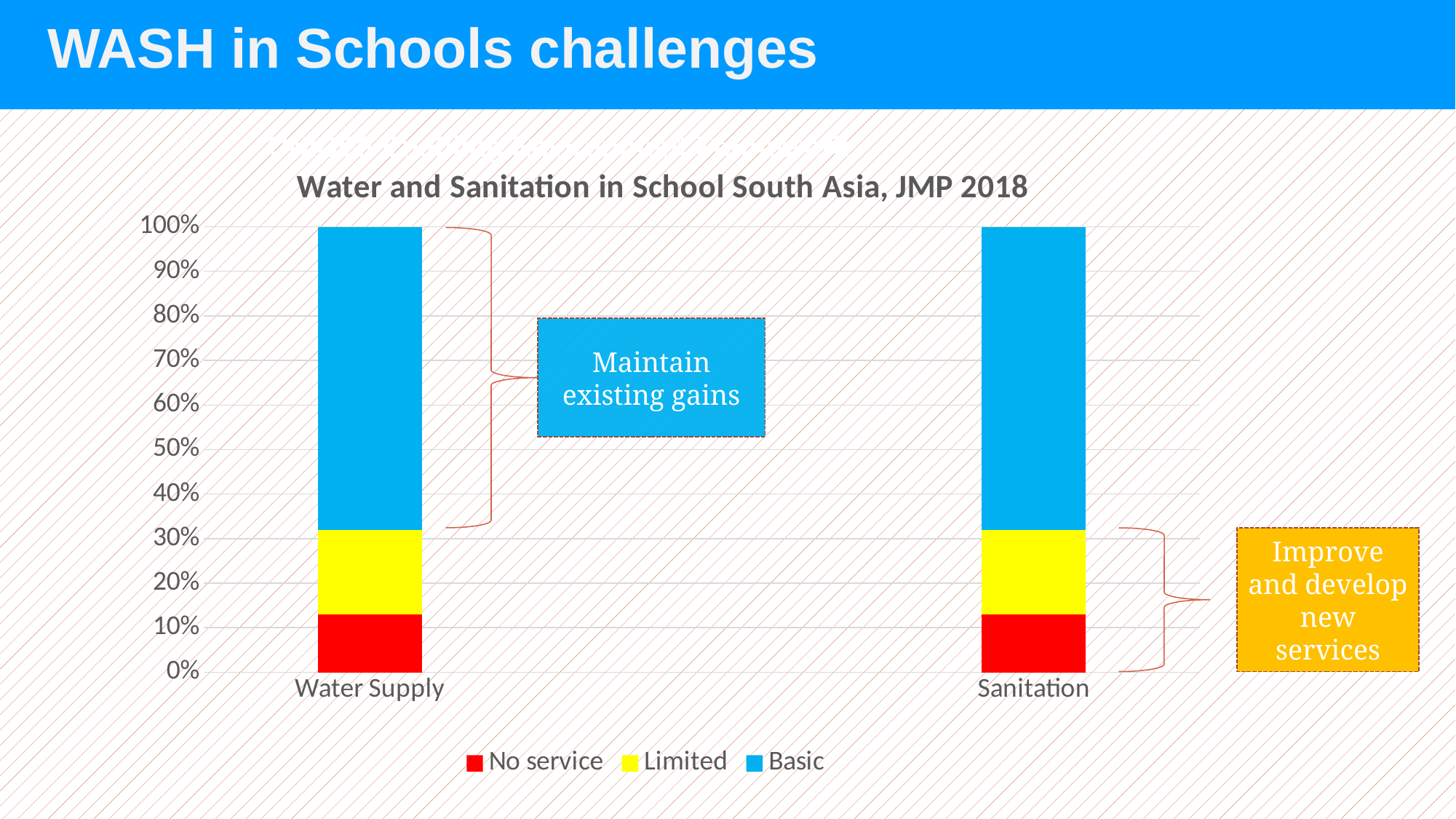
Which series makes up the smallest share of the Water Supply bar? No service Which colour represents the Basic series in the chart? Blue What is the total of the stacked bar for Water Supply? 100% Is the value for No service in Sanitation greater or less than 20%? less In the Sanitation bar, which is larger: the Basic segment or the Limited segment? Basic What is the title of the chart? Water and Sanitation in School South Asia, JMP 2018 Which series makes up the largest share of the Sanitation bar? Basic How many categories are shown on the x axis of the chart? 2 What kind of chart is shown on the slide? Stacked bar chart Is the value for Basic in Sanitation greater or less than 60%? greater How many series does the chart legend list? 3 Is the value for Basic in Water Supply greater or less than 50%? greater